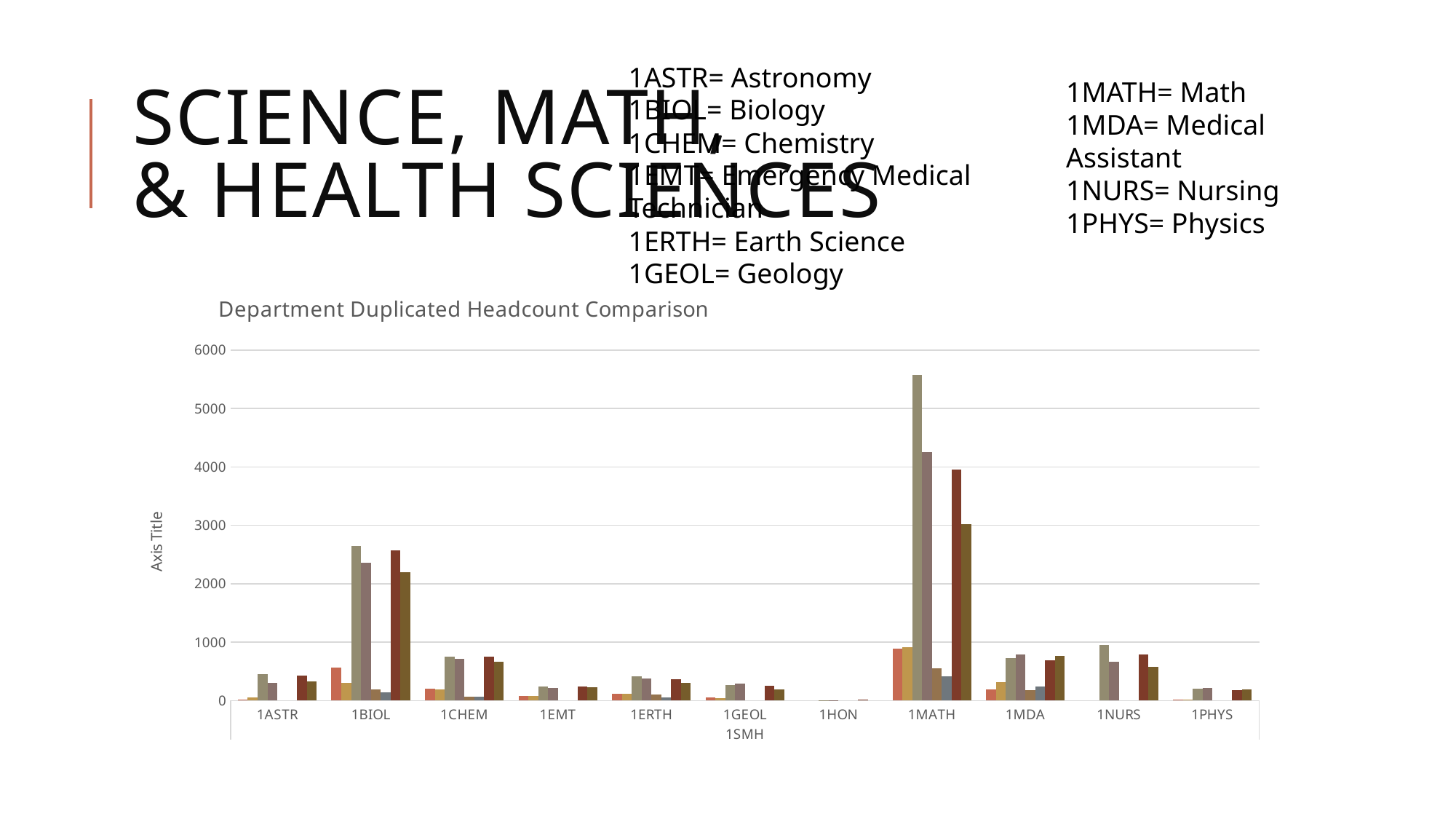
Is the tallest bar for 1BIOL greater or less than 2000? greater Is the tallest bar for 1CHEM greater or less than 1000? less Which category has a taller maximum bar, 1BIOL or 1CHEM? 1BIOL What is the title of the chart? Department Duplicated Headcount Comparison What kind of chart is shown on the slide? bar chart What is the highest value shown on the vertical axis of the chart? 6000 What is the label shown on the vertical axis of the chart? Axis Title Are the bars for 1HON greater or less than 1000? less Which category has a taller maximum bar, 1MATH or 1NURS? 1MATH Which department category has the tallest bar in the chart? 1MATH How many department categories are shown on the x axis of the chart? 11